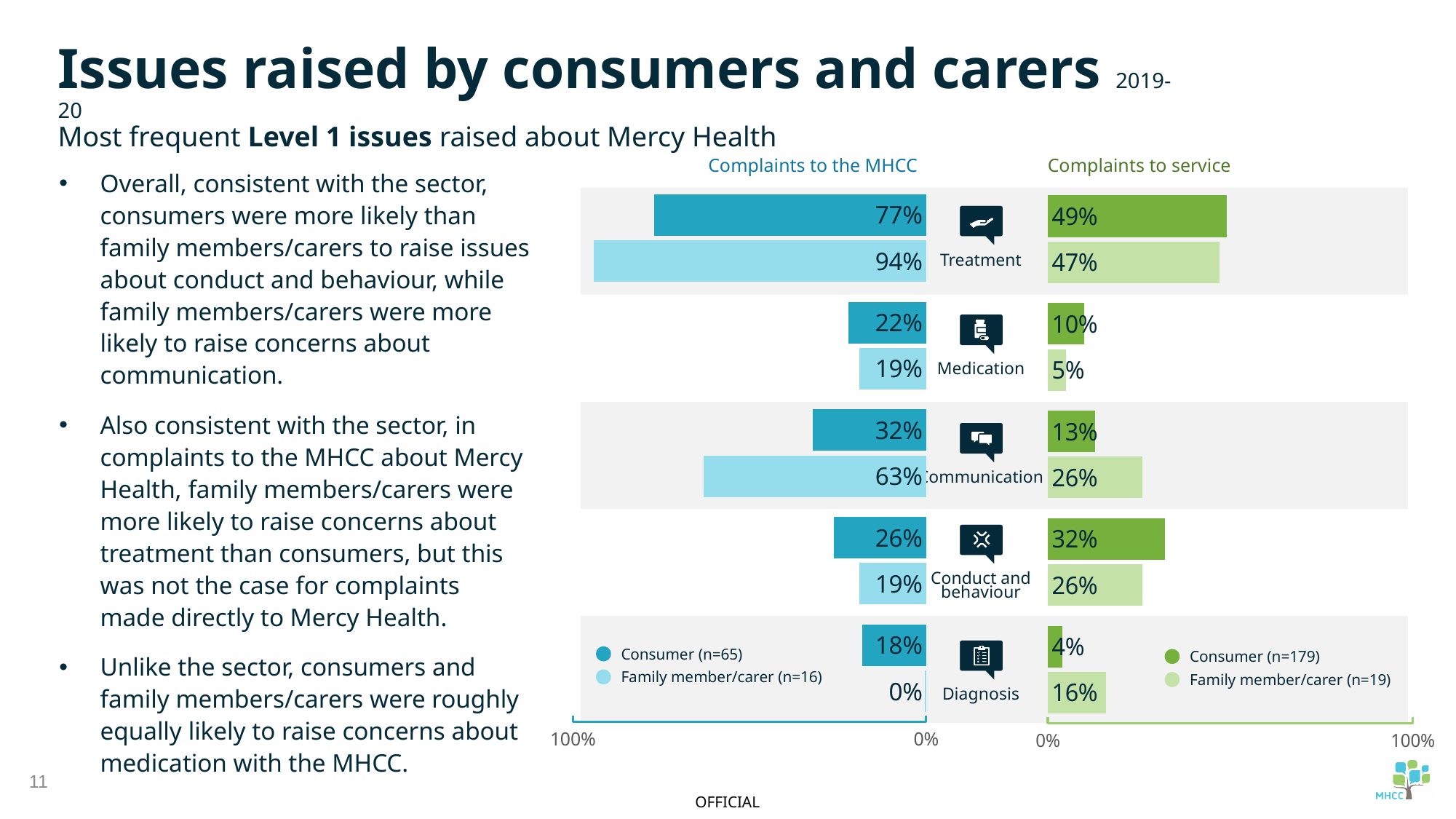
In the 'Complaints to service' chart, what percentage of family member/carer complaints raised Diagnosis? 16% In the 'Complaints to the MHCC' chart, what percentage of family member/carer complaints raised Communication? 63% How many series does the legend of the 'Complaints to service' chart list? 2 In the 'Complaints to service' chart, what percentage of consumer complaints raised Conduct and behaviour? 32% How many issue categories are shown in the 'Complaints to the MHCC' chart? 5 In the 'Complaints to the MHCC' chart, which issue has the highest value for family member/carer? Treatment In the 'Complaints to service' chart, which issue has the lowest value for consumers? Diagnosis In the 'Complaints to the MHCC' chart, which is larger for Conduct and behaviour: the consumer value or the family member/carer value? Consumer What type of chart is the 'Complaints to the MHCC' chart? Bar chart In the 'Complaints to the MHCC' chart, what percentage of consumer complaints raised Treatment? 77% In the 'Complaints to service' chart, what is the difference between the family member/carer and consumer values for Communication? 13% In the 'Complaints to the MHCC' chart, what is the difference between the family member/carer and consumer values for Treatment? 17%